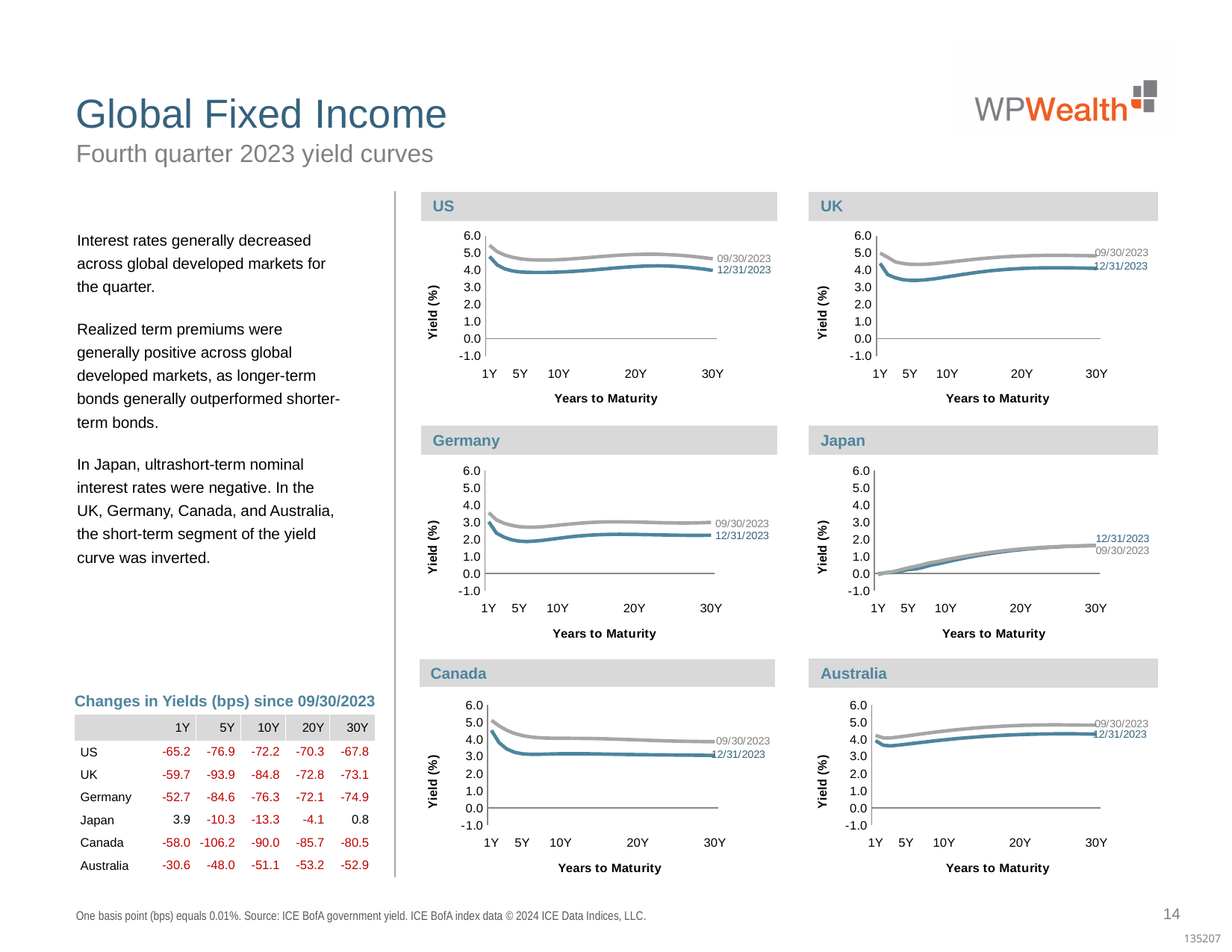
In the US chart, which series is higher at 1Y, 09/30/2023 or 12/31/2023? 09/30/2023 How many series does the US chart show? 2 In the Canada chart, which series is higher at 5Y, 09/30/2023 or 12/31/2023? 09/30/2023 In the Japan chart, do yields rise or fall as years to maturity increase? rise In the US chart, is the 12/31/2023 value at 1Y greater or less than 4.0? greater In the UK chart, is the 12/31/2023 value at 5Y greater or less than 3.0? greater What is the y-axis title of the Germany chart? Yield (%) In the Germany chart, is the 09/30/2023 value at 1Y greater or less than 3.0? greater What kind of chart is the US chart? line chart How many maturity labels are shown on the x axis of the Canada chart? 5